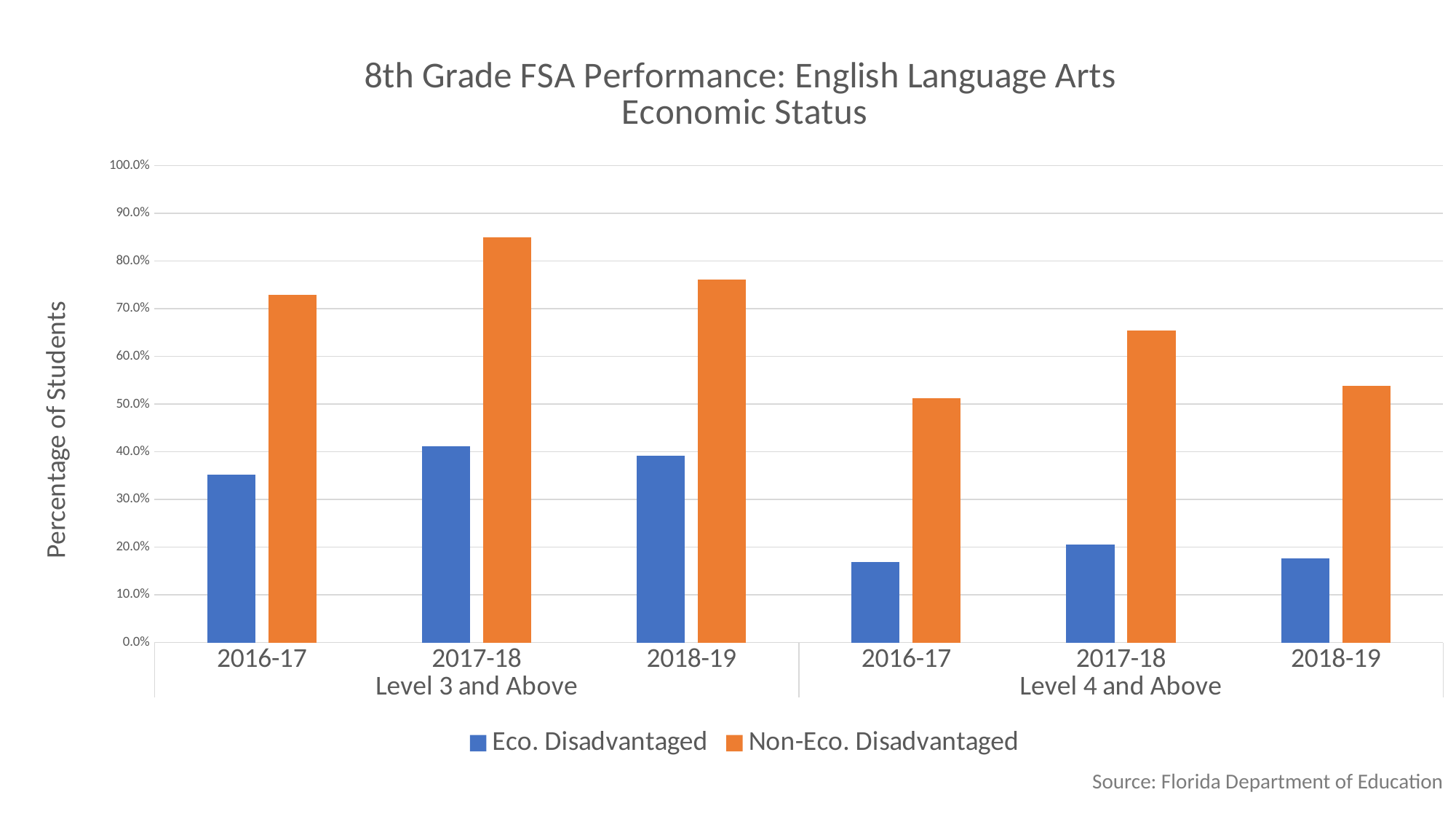
What is the label on the vertical axis? Percentage of Students How many bars are plotted in the chart in total? 12 Is the Eco. Disadvantaged value for 2016-17 in the Level 3 and Above group greater or less than 40.0%? less How do the Non-Eco. Disadvantaged values change across the three years in the Level 4 and Above group? Rise from 2016-17 to 2017-18, then fall in 2018-19 What kind of chart is shown on the slide? Bar chart Which bar is the highest in the whole chart? Non-Eco. Disadvantaged, 2017-18, Level 3 and Above Is the Non-Eco. Disadvantaged value for 2017-18 in the Level 4 and Above group greater or less than 60.0%? greater Is the Non-Eco. Disadvantaged value for 2017-18 in the Level 3 and Above group greater or less than 80.0%? greater How many series does the legend list? 2 Which is larger: the Non-Eco. Disadvantaged value for 2018-19 in Level 3 and Above, or the Non-Eco. Disadvantaged value for 2017-18 in Level 4 and Above? Non-Eco. Disadvantaged 2018-19, Level 3 and Above Within the Level 3 and Above group, which year has the lowest Eco. Disadvantaged value? 2016-17